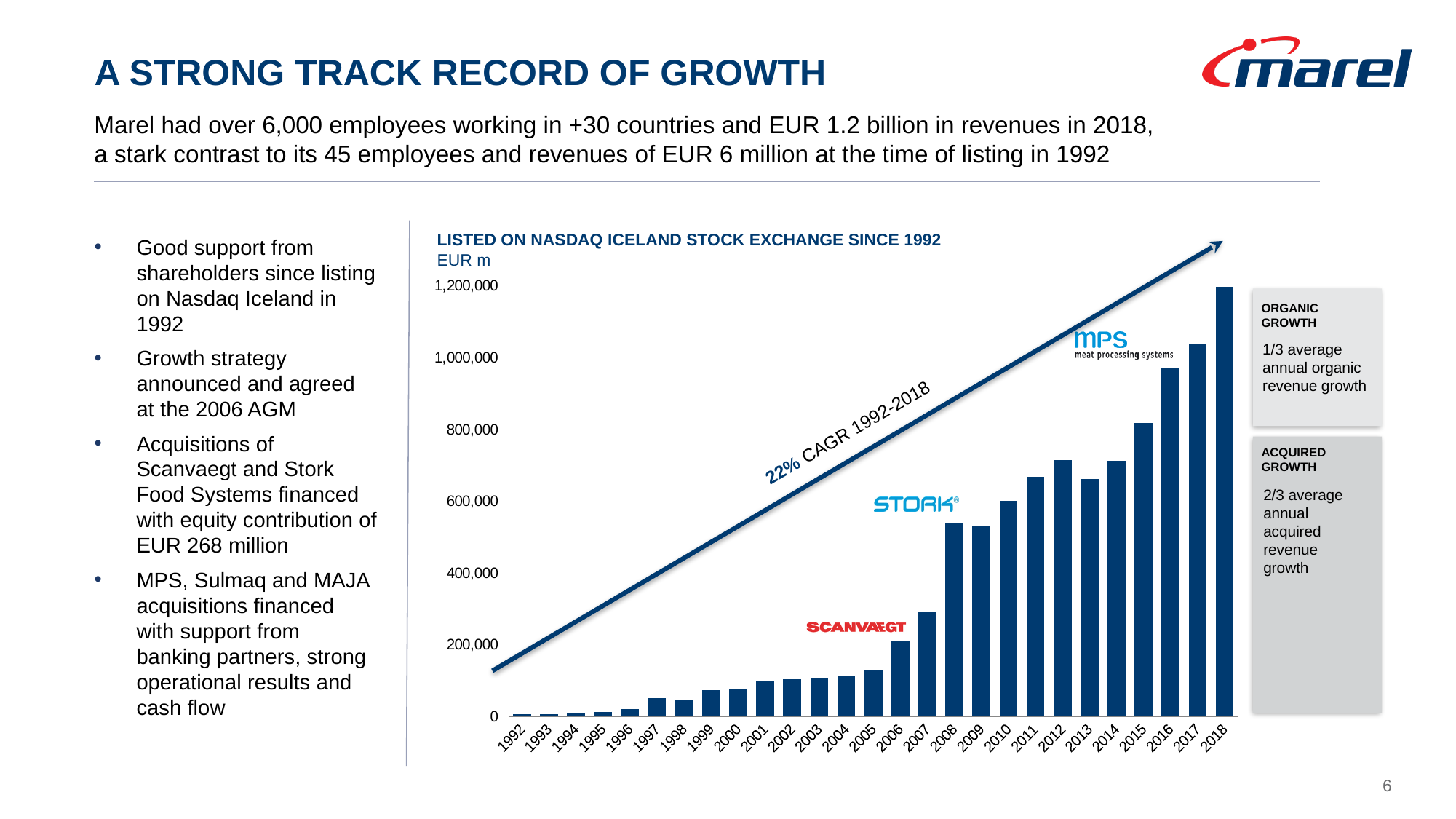
What unit is stated for the chart's values? EUR m Do the values generally rise or fall from 1992 to 2018? rise Is the value for 2005 greater or less than 200,000? less Which year has the lowest bar in the chart? 1992 Is the value for 2012 greater or less than 600,000? greater How many years are plotted on the x axis of the chart? 27 What kind of chart is shown on the slide? bar chart Which year has the larger value, 2012 or 2013? 2012 Is the value for 2008 greater or less than 600,000? less Which year has the highest bar in the chart? 2018 What CAGR for 1992-2018 is shown on the chart? 22%